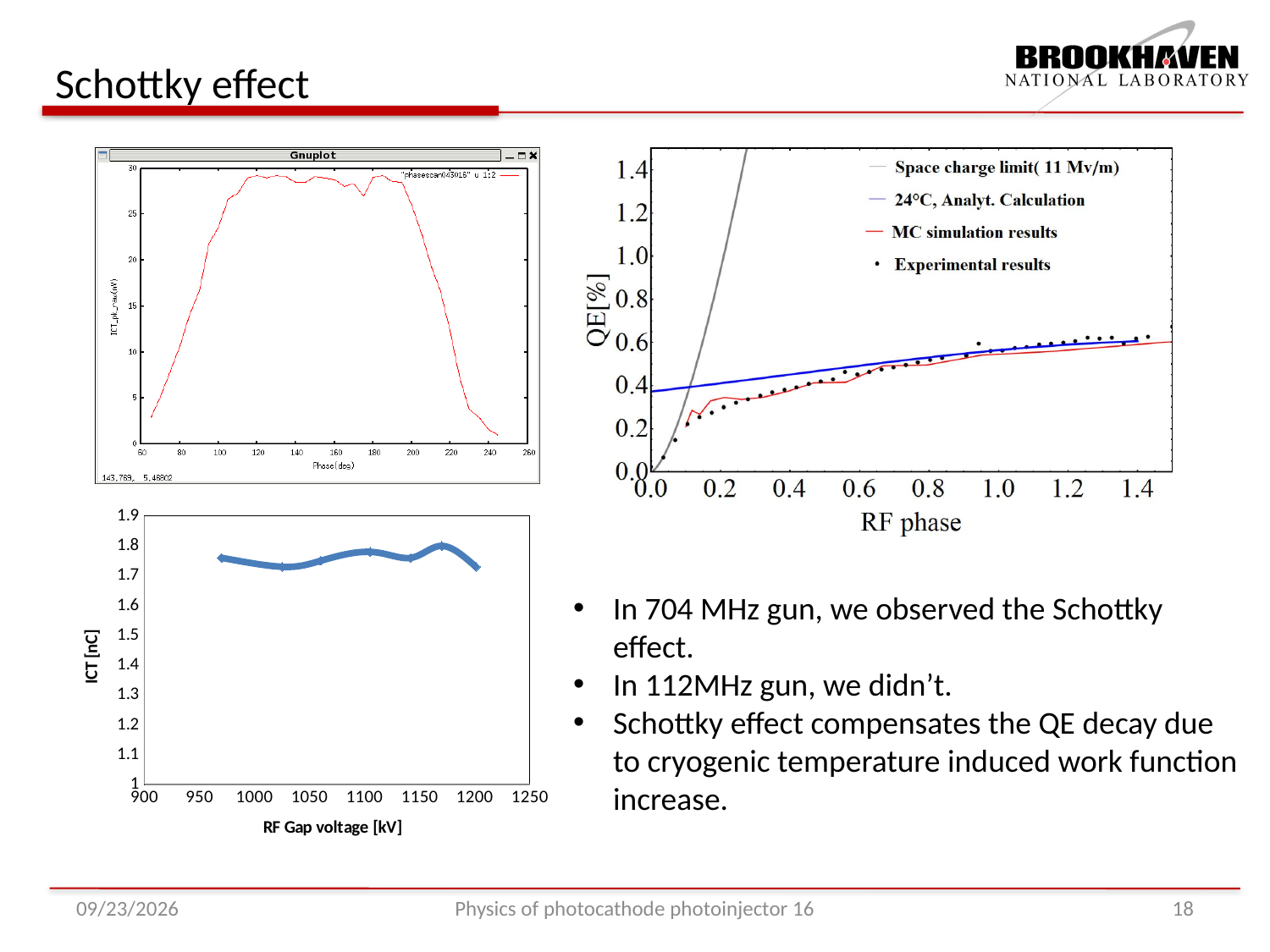
In the bottom-left chart, what is the label of the y axis? ICT [nC] What kind of chart is the bottom-left chart with the x axis 'RF Gap voltage [kV]'? line chart In the right-hand chart, is the experimental QE value at an RF phase of 0.2 greater or less than 0.4? less In the right-hand chart (QE vs RF phase), do the experimental results rise or fall as RF phase increases from 0.0 to 1.4? rise In the bottom-left chart, is the ICT value at an RF gap voltage of about 1030 kV greater or less than 1.8? less In the top-left Gnuplot chart, is the value at a phase of 240 deg greater or less than 5? less In the right-hand chart, which legend entry is drawn with a red line? MC simulation results How many entries does the legend of the right-hand chart (QE vs RF phase) list? 4 In the bottom-left chart, what is the highest value shown on the y axis? 1.9